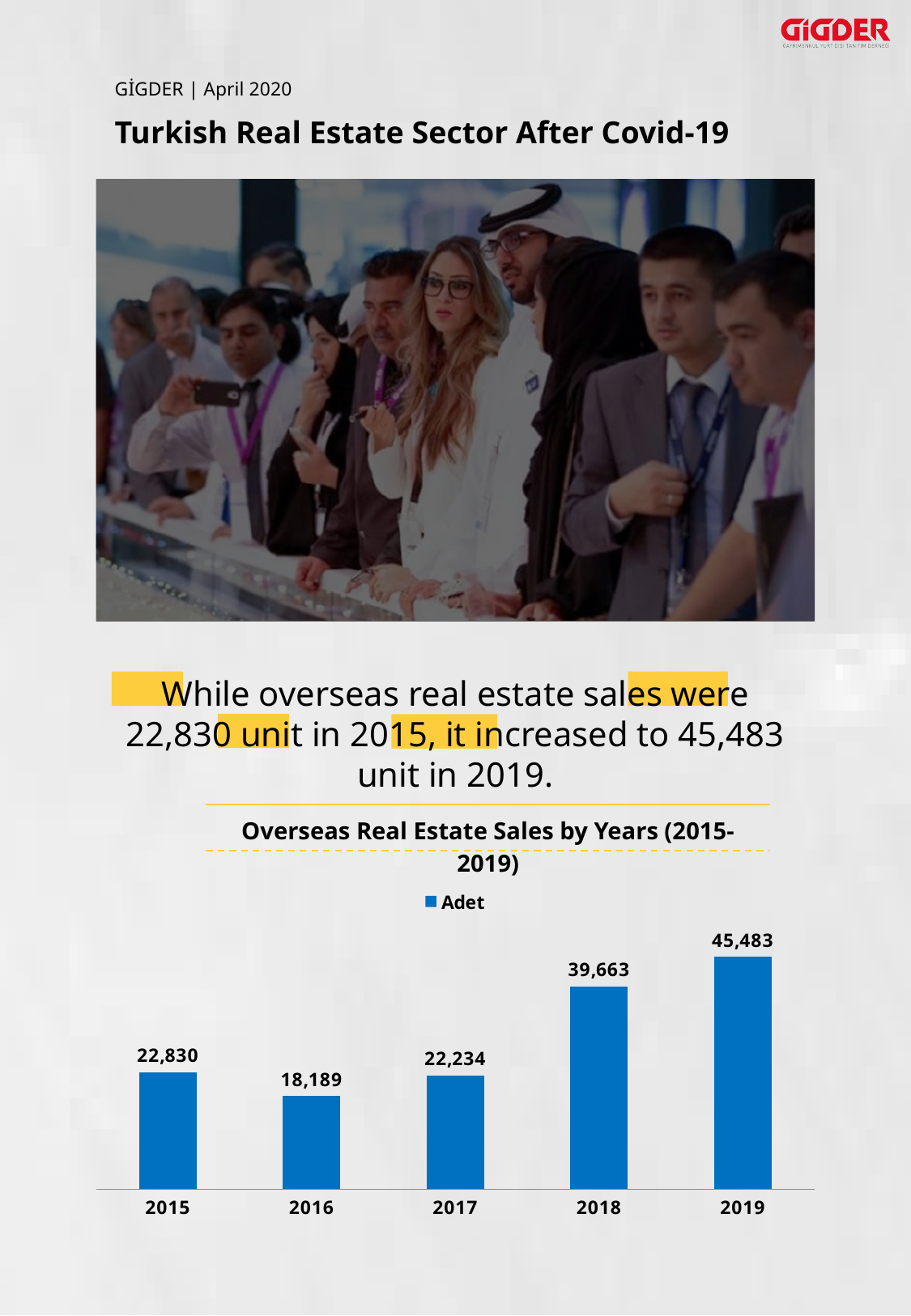
What is the name of the series shown in the chart's legend? Adet Which year has the lowest overseas real estate sales in the chart? 2016 Which year has the highest overseas real estate sales in the chart? 2019 What is the value for 2015 in the Overseas Real Estate Sales by Years chart? 22,830 How many series does the chart's legend list? 1 Which is larger in the chart, the value for 2017 or the value for 2016? 2017 What is the value for 2016 in the chart? 18,189 What is the difference between the 2019 and 2015 values in the chart? 22,653 How many years are shown on the x axis of the chart? 5 What is the value for 2018 in the chart? 39,663 What kind of chart is shown on the slide? Bar chart What is the difference between the 2018 and 2017 values in the chart? 17,429